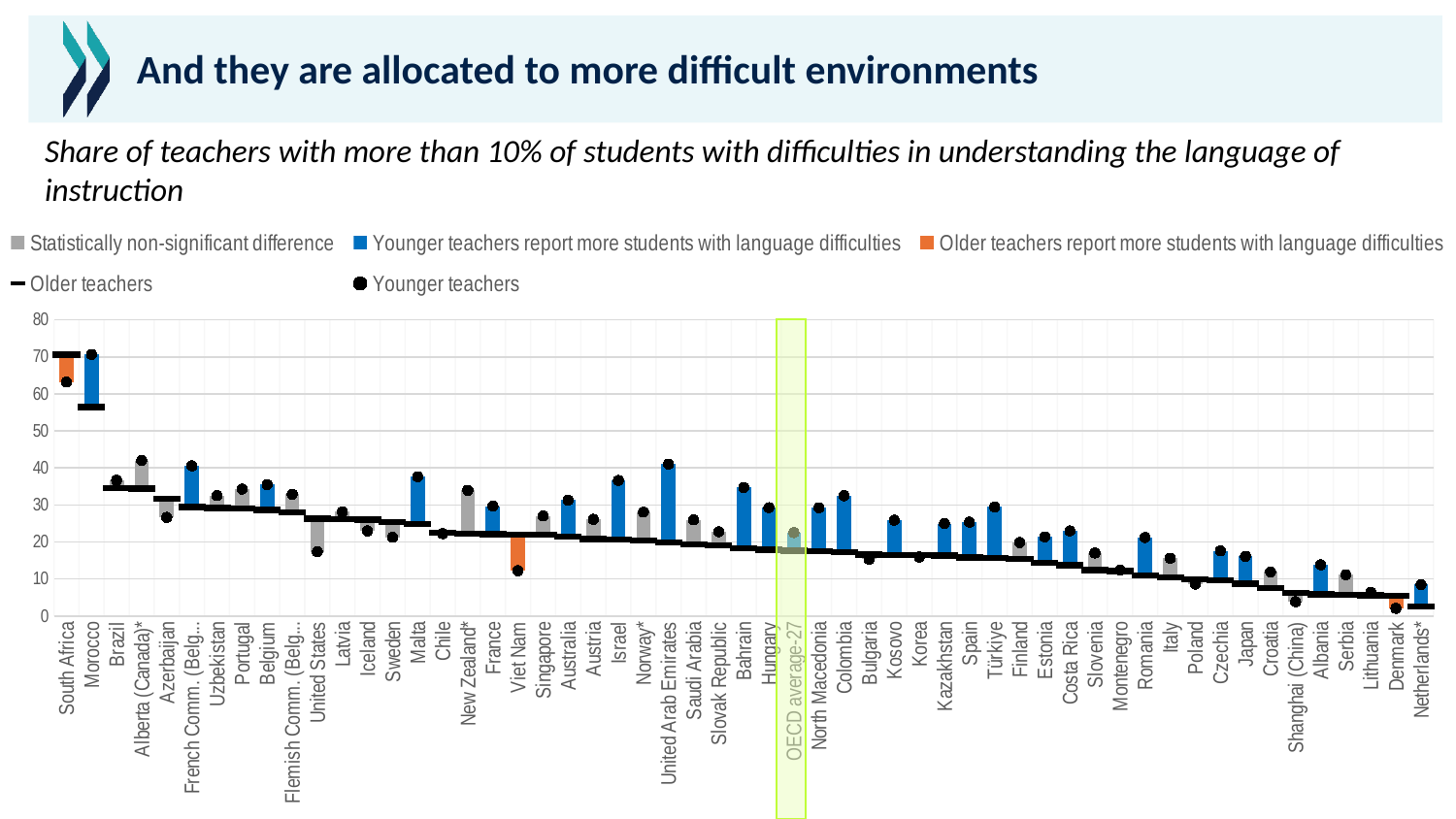
In Morocco, which is larger: the value for younger teachers or the value for older teachers? younger teachers According to the legend, what colour are the bars where younger teachers report more students with language difficulties? blue Which category has the highest value for older teachers? South Africa Do the values for older teachers rise or fall moving from left to right along the x axis? fall Is the value for younger teachers in Malta greater or less than 30? greater What kind of chart is shown on the slide? bar chart Is the value for older teachers in South Africa greater or less than 60? greater Which category has the lowest value for older teachers? Netherlands* Which category has the highest value for younger teachers? Morocco How many entries does the legend list? 5 Is the value for younger teachers in Viet Nam greater or less than 20? less In Viet Nam, which is larger: the value for younger teachers or the value for older teachers? older teachers